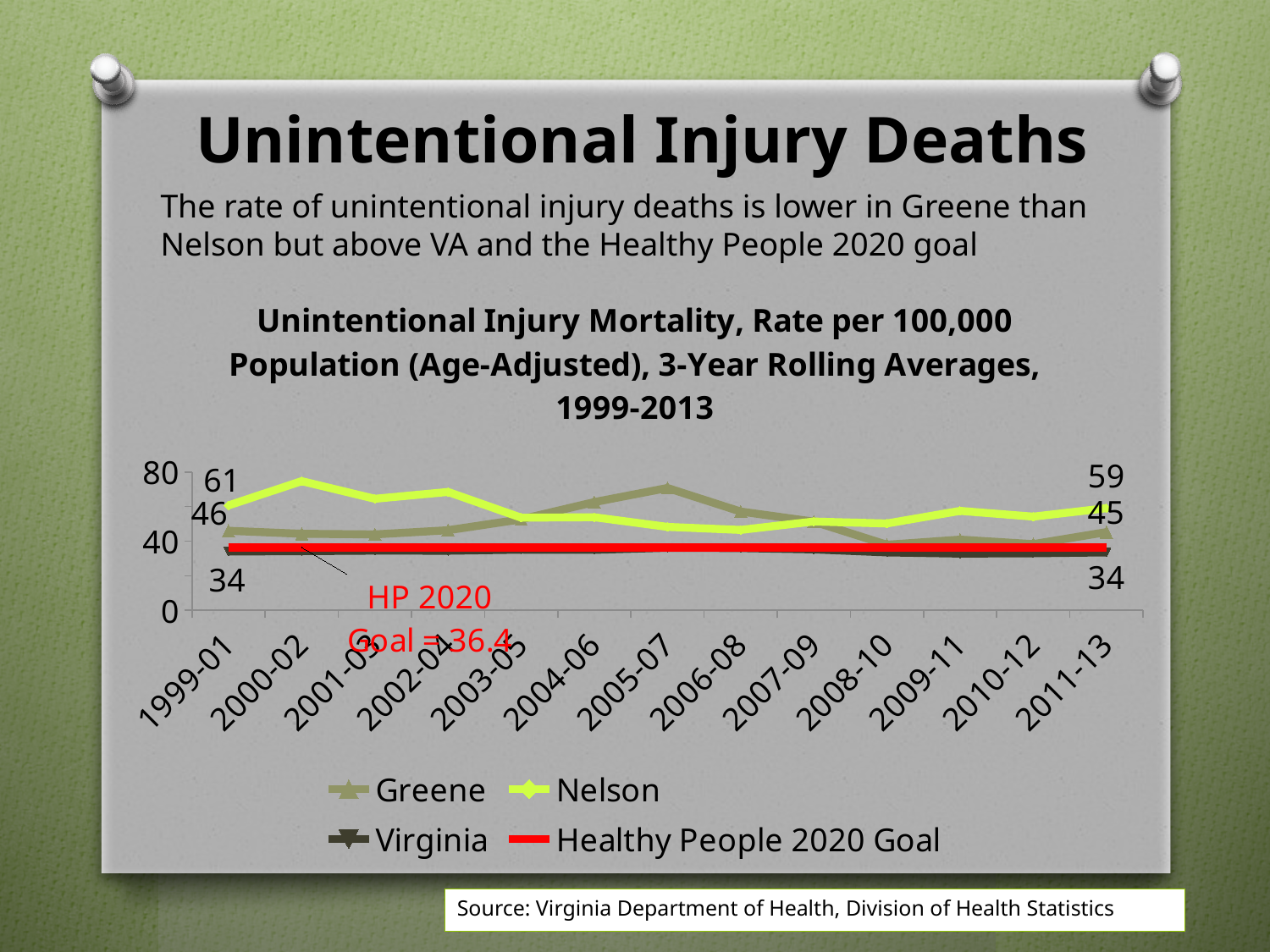
How many time periods are shown along the x axis of the chart? 13 What is the Virginia value for 1999-01? 34 How many series does the chart legend list? 4 What is the Nelson value for 1999-01? 61 What kind of chart is shown on the slide? line chart What is the Healthy People 2020 Goal value shown on the chart? 36.4 Is the Nelson value for 2000-02 greater or less than 40? greater What is the difference between the Nelson and Greene values in 1999-01? 15 In 2011-13, which is higher, Greene or Nelson? Nelson What colour is the Healthy People 2020 Goal line on the chart? red What is the Greene value for 2011-13? 45 By how much did the Nelson value change from 1999-01 (61) to 2011-13 (59)? 2